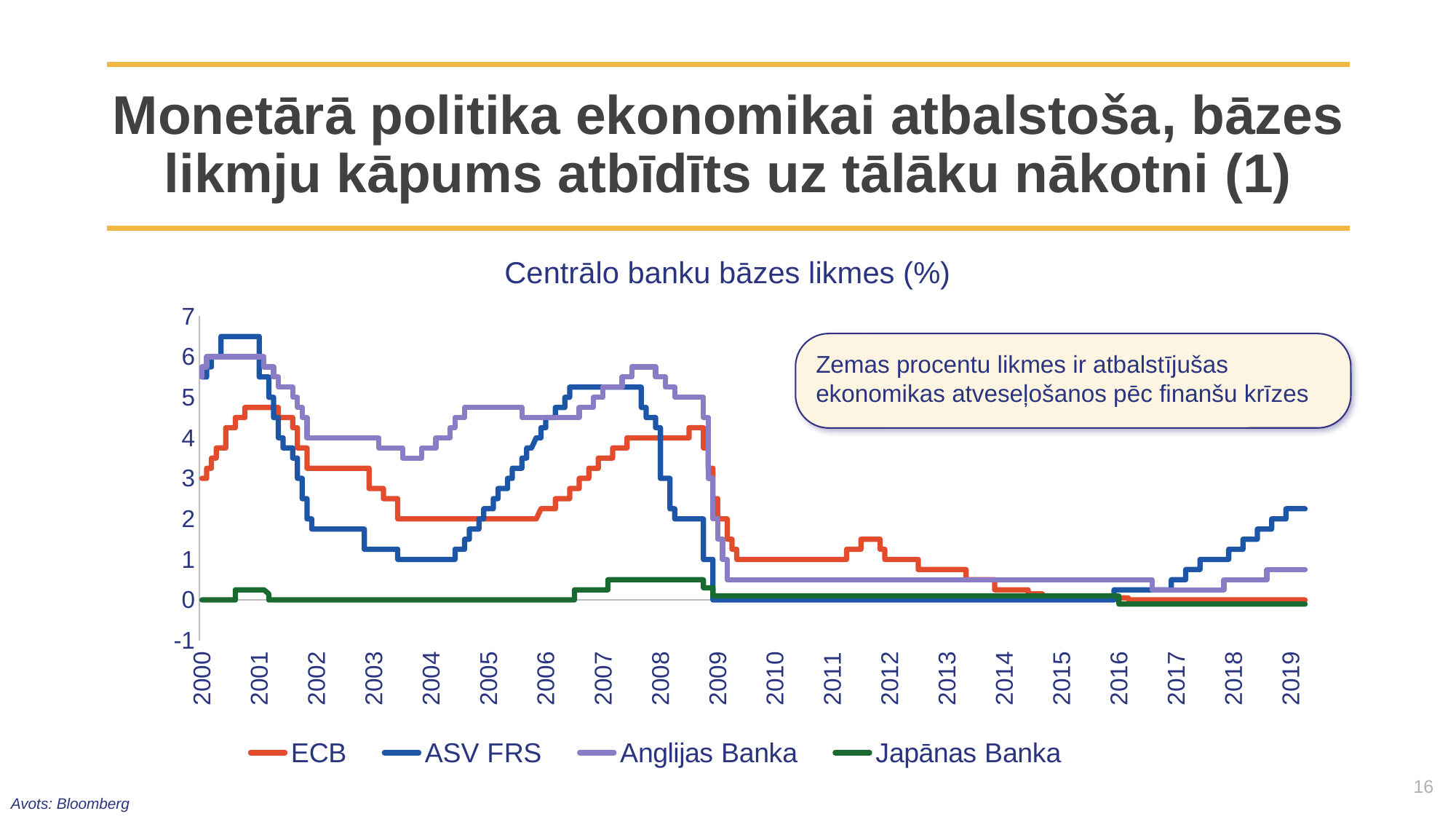
In 2004, which is higher: Anglijas Banka or ASV FRS? Anglijas Banka Is the value for ASV FRS in 2019 greater or less than 2? greater How many series does the legend list? 4 Which series are listed in the chart legend? ECB, ASV FRS, Anglijas Banka, Japānas Banka What is the title of the chart? Centrālo banku bāzes likmes (%) What kind of chart is shown on the slide? Line chart Is the value for Anglijas Banka in 2019 greater or less than 1? less How many year labels are shown on the x axis? 20 Which series has the highest value in 2019? ASV FRS Which series has the lowest value in 2004? Japānas Banka